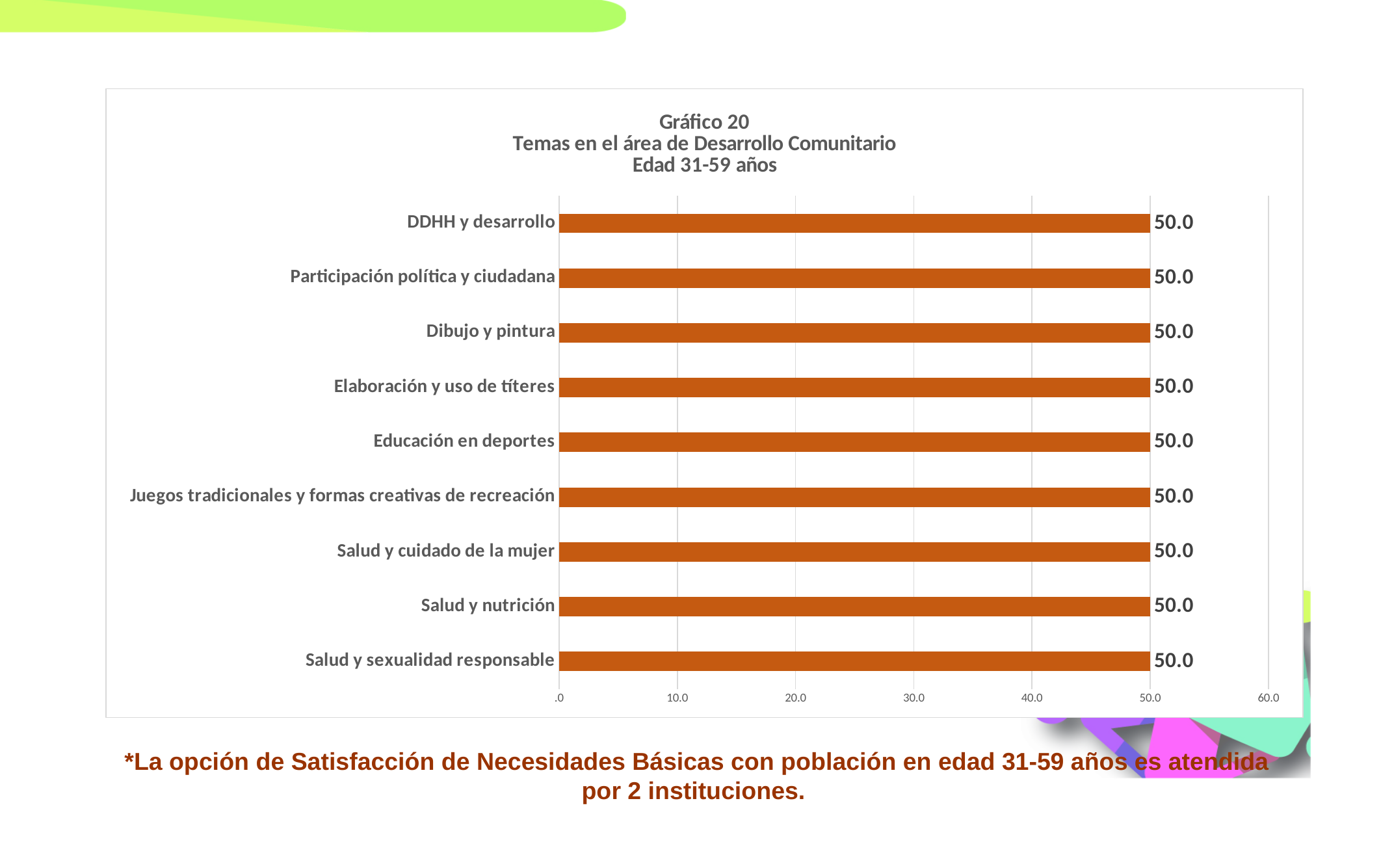
What is the difference between the values for Dibujo y pintura and Salud y cuidado de la mujer? 0.0 What kind of chart is shown on the slide? Bar chart Is the value for Elaboración y uso de títeres greater or less than 60.0? less What is the value for Salud y nutrición? 50.0 What colour are the bars in the chart? Orange Is the value for Participación política y ciudadana greater or less than 40.0? greater How many categories are shown in the chart? 9 What is the value for Educación en deportes? 50.0 What is the value for Salud y sexualidad responsable? 50.0 What age range is named in the chart title? 31-59 años What is the value for Juegos tradicionales y formas creativas de recreación? 50.0 What is the value for DDHH y desarrollo? 50.0